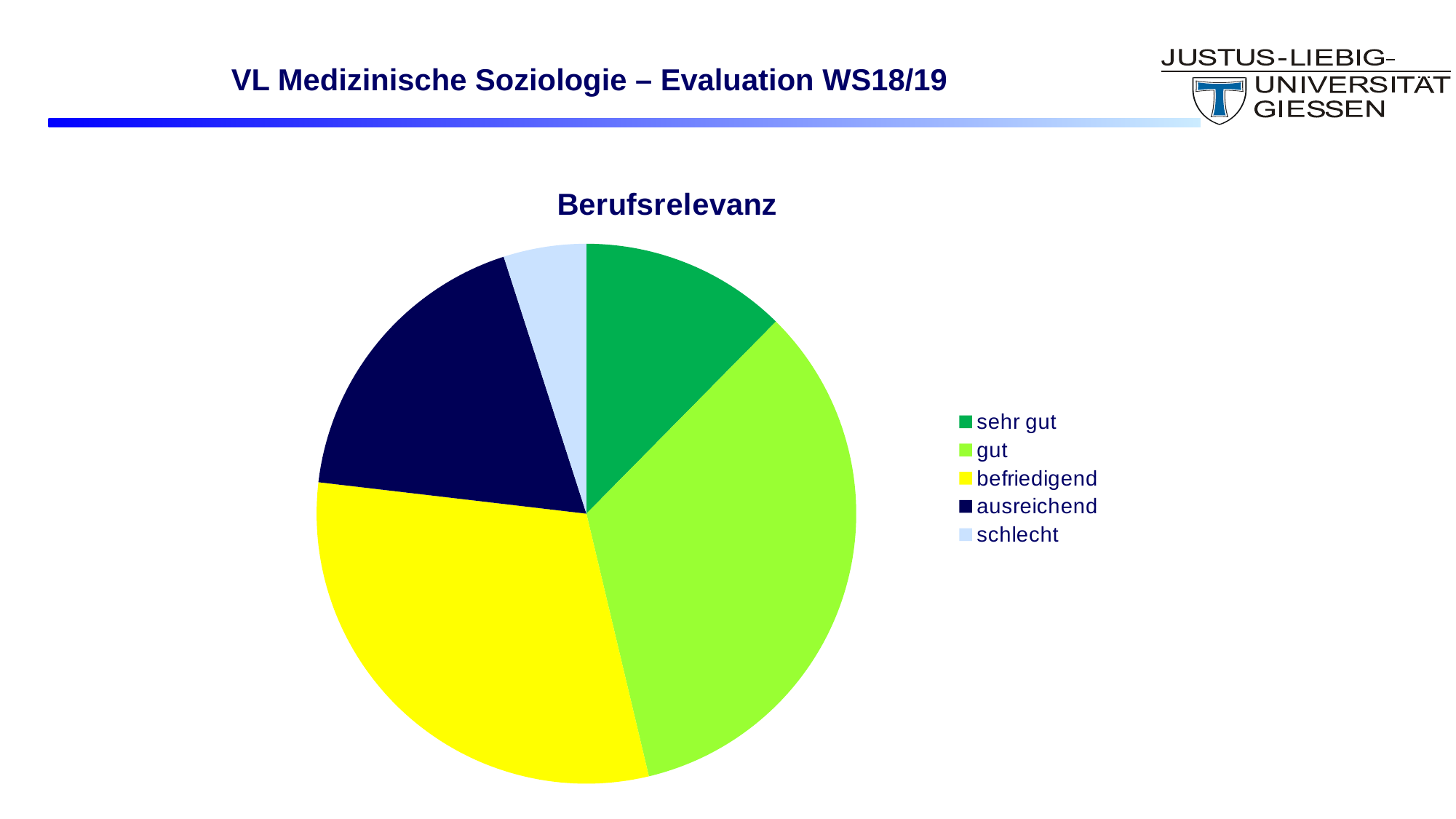
Which slice is larger, befriedigend or sehr gut? befriedigend Which slice is larger, befriedigend or schlecht? befriedigend What kind of chart is shown on the slide? pie chart Which slice is larger, gut or sehr gut? gut How many slices does the pie chart have? 5 Which legend entry is shown in yellow? befriedigend What is the title of the chart? Berufsrelevanz How many entries does the legend list? 5 Which category has the smallest slice of the pie? schlecht